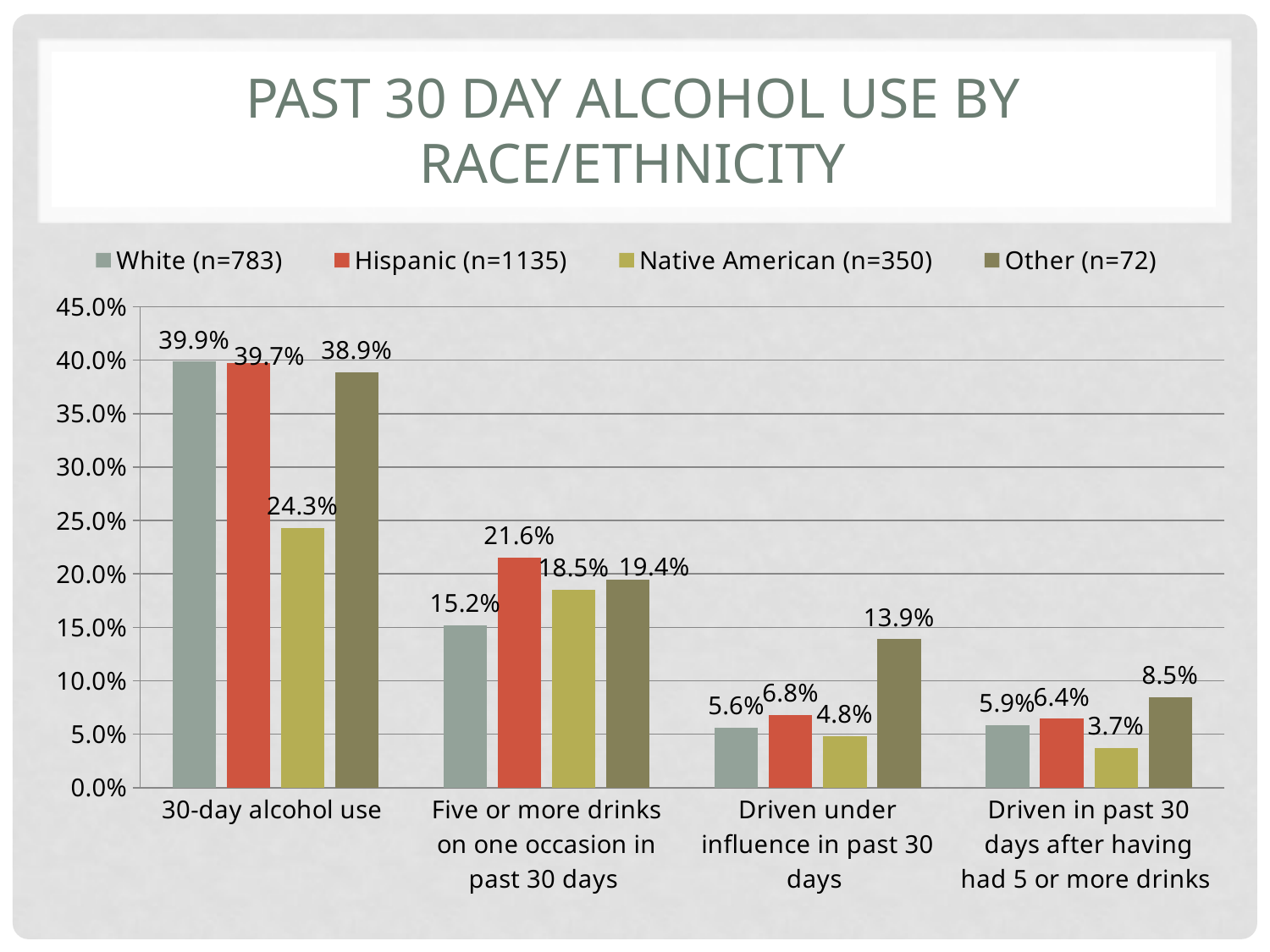
What is the difference between the Hispanic and White values for five or more drinks on one occasion in past 30 days? 6.4% Do the values for the White series rise or fall from the first category to the last? Fall What is the value for Native American (n=350) in the 30-day alcohol use category? 24.3% What is the value for Hispanic (n=1135) for five or more drinks on one occasion in past 30 days? 21.6% What is the title of the chart? Past 30 Day Alcohol Use by Race/Ethnicity Which group has the lowest value for driven under influence in past 30 days? Native American (n=350) What is the value for Other (n=72) for driven under influence in past 30 days? 13.9% What kind of chart is shown on the slide? Bar chart Which group has the highest value for driven in past 30 days after having had 5 or more drinks? Other (n=72) How many series does the legend list? 4 How many categories are shown on the x axis? 4 Which is larger for 30-day alcohol use: the White value or the Native American value? White